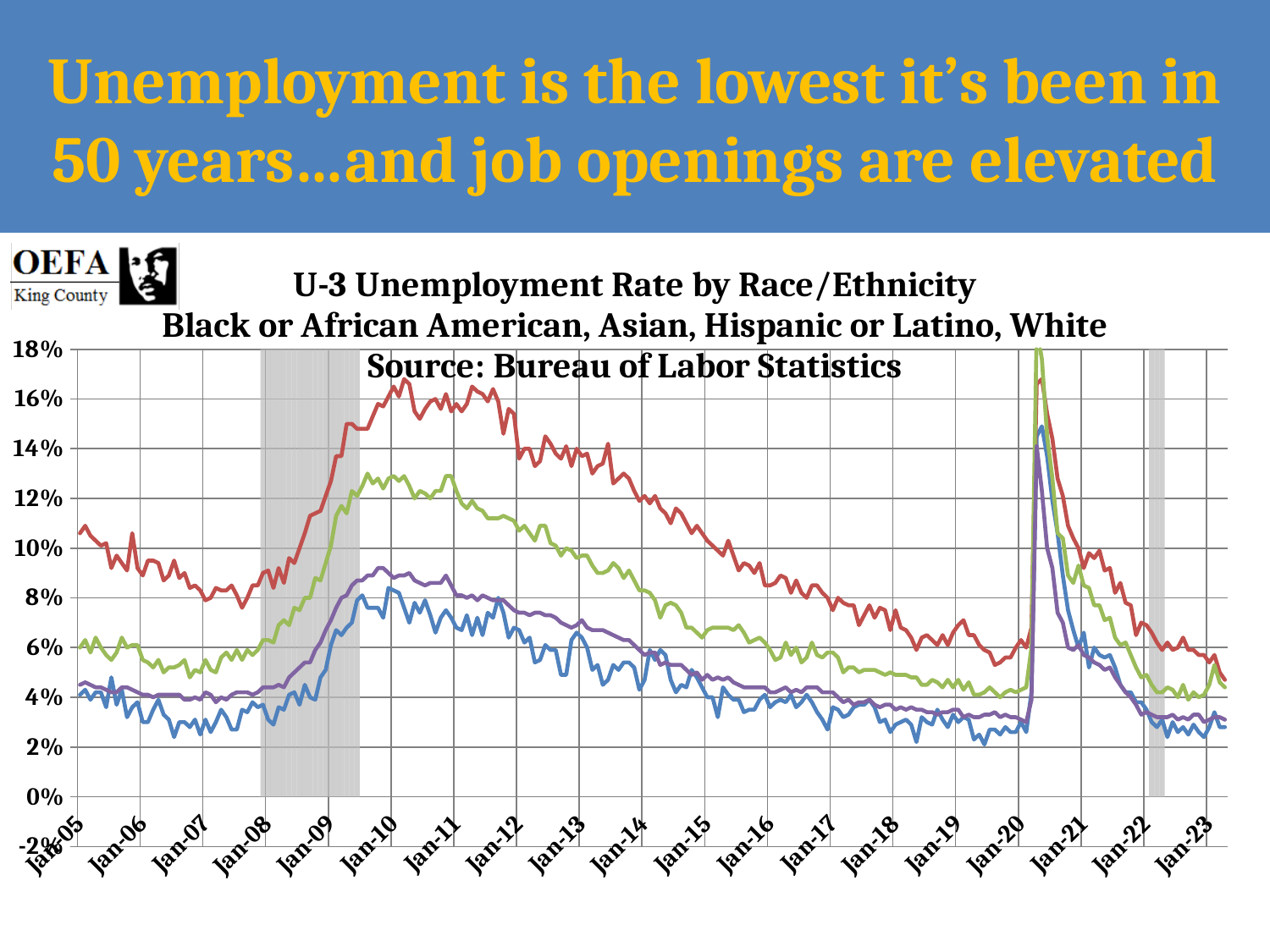
Is the value of the red line at Jan-10 greater or less than 14%? greater How many lines are plotted on the chart? 4 Does the red line rise or fall between Jan-11 and Jan-20? fall Is the value of the purple line at Jan-10 greater or less than 8%? greater At Jan-12, which is higher, the red line or the green line? the red line Is the value of the green line at Jan-10 greater or less than 10%? greater What kind of chart is shown on the slide? line chart What is the highest value labelled on the y axis of the chart? 18% Which line has the highest value at Jan-10? the red line What is the source of the data cited in the chart title? Bureau of Labor Statistics